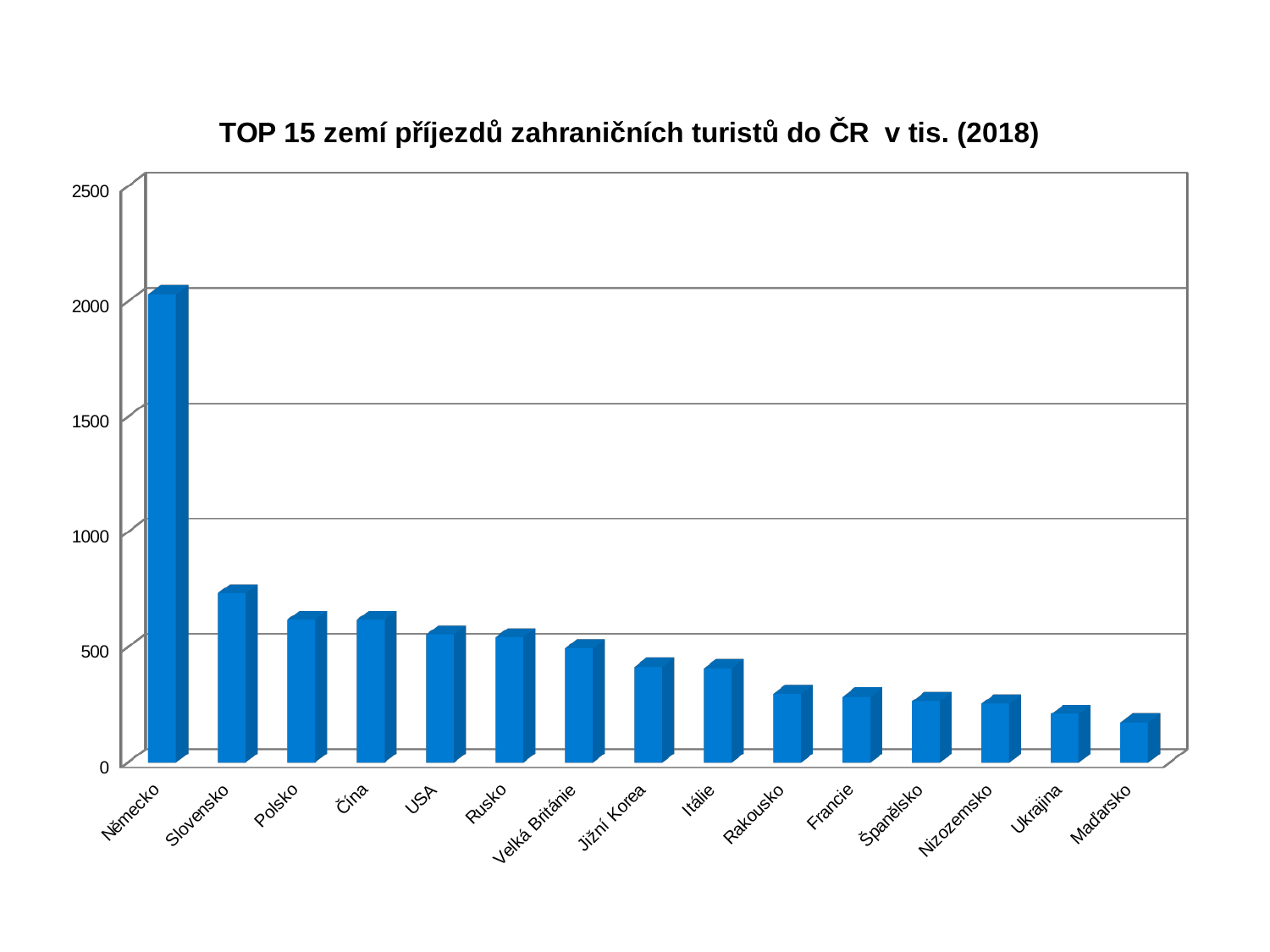
Which country has the lowest value in the chart? Maďarsko Which has a larger value, Slovensko or Polsko? Slovensko Is the value for Slovensko greater or less than 500? greater How many countries are shown on the x axis of the chart? 15 Is the value for Německo greater or less than 1500? greater Which country has the highest value in the chart? Německo Is the value for Rakousko greater or less than 500? less Do the values generally rise or fall from left to right along the x axis? fall What is the title of the chart? TOP 15 zemí příjezdů zahraničních turistů do ČR v tis. (2018) What kind of chart is shown on the slide? bar chart